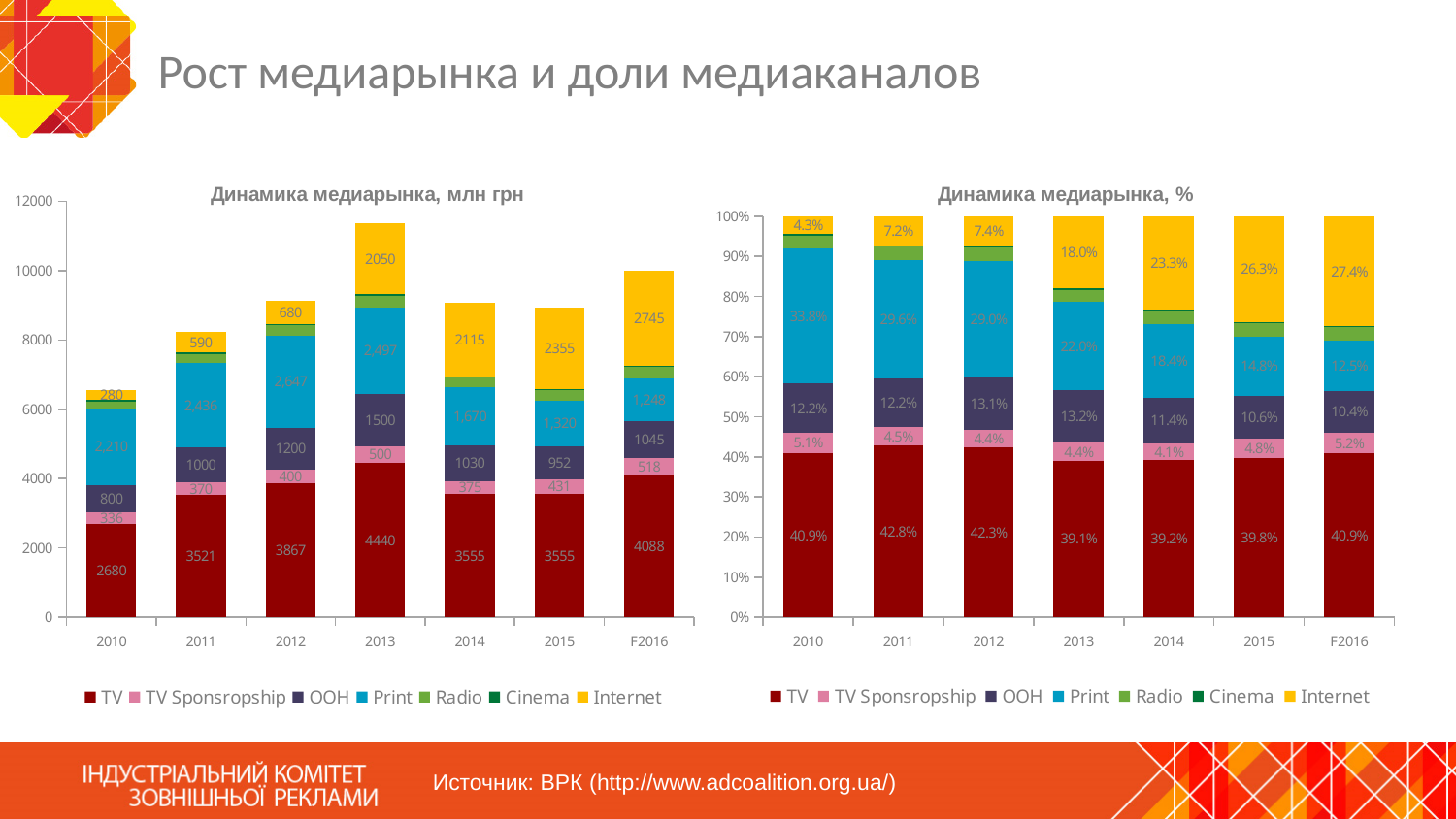
In the left chart (Динамика медиарынка, млн грн), is the total height of the 2013 bar greater or less than 10000? greater In the left chart (Динамика медиарынка, млн грн), what is the TV value for 2013? 4440 In the left chart (Динамика медиарынка, млн грн), which is larger: the Internet value for 2014 or the Print value for 2014? Internet (2115) In the right chart (Динамика медиарынка, %), does the Print share rise or fall from 2010 to F2016? Fall In the left chart (Динамика медиарынка, млн грн), which year has the lowest Internet value? 2010 In the right chart (Динамика медиарынка, %), what is the TV share for 2011? 42.8% What kind of chart is the right chart (Динамика медиарынка, %)? Stacked bar chart In the left chart (Динамика медиарынка, млн грн), what is the Internet value for F2016? 2745 In the left chart (Динамика медиарынка, млн грн), what is the difference between the OOH values for 2013 and 2010? 700 How many years are shown on the x axis of the left chart (Динамика медиарынка, млн грн)? 7 In the left chart (Динамика медиарынка, млн грн), which year has the highest Print value? 2012 How many series does the legend of the right chart (Динамика медиарынка, %) list? 7